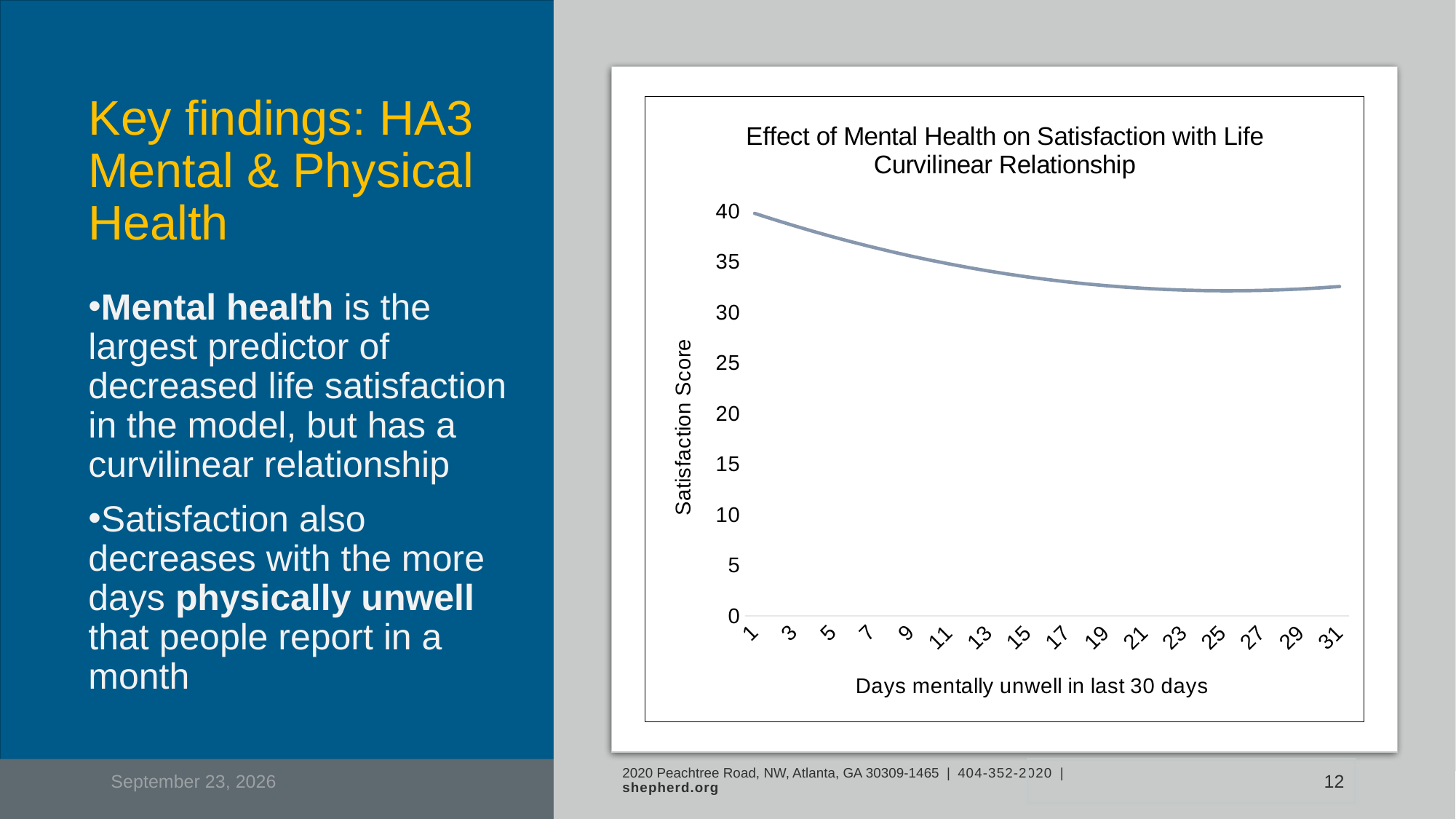
What is the highest value shown on the y axis? 40 Is the satisfaction score at 1 day mentally unwell greater or less than 35? greater Is the satisfaction score at 11 days mentally unwell greater or less than 40? less At which number of days mentally unwell is the satisfaction score highest? 1 What is the title of the chart? Effect of Mental Health on Satisfaction with Life Curvilinear Relationship Is the satisfaction score at 21 days mentally unwell greater or less than 30? greater Which has a higher satisfaction score: 1 day or 31 days mentally unwell? 1 day What is the label of the y axis? Satisfaction Score How does the satisfaction score change as days mentally unwell increase from 1 to 31? falls, then levels off What kind of chart is shown on the slide? line chart How many tick labels are shown on the x axis? 16